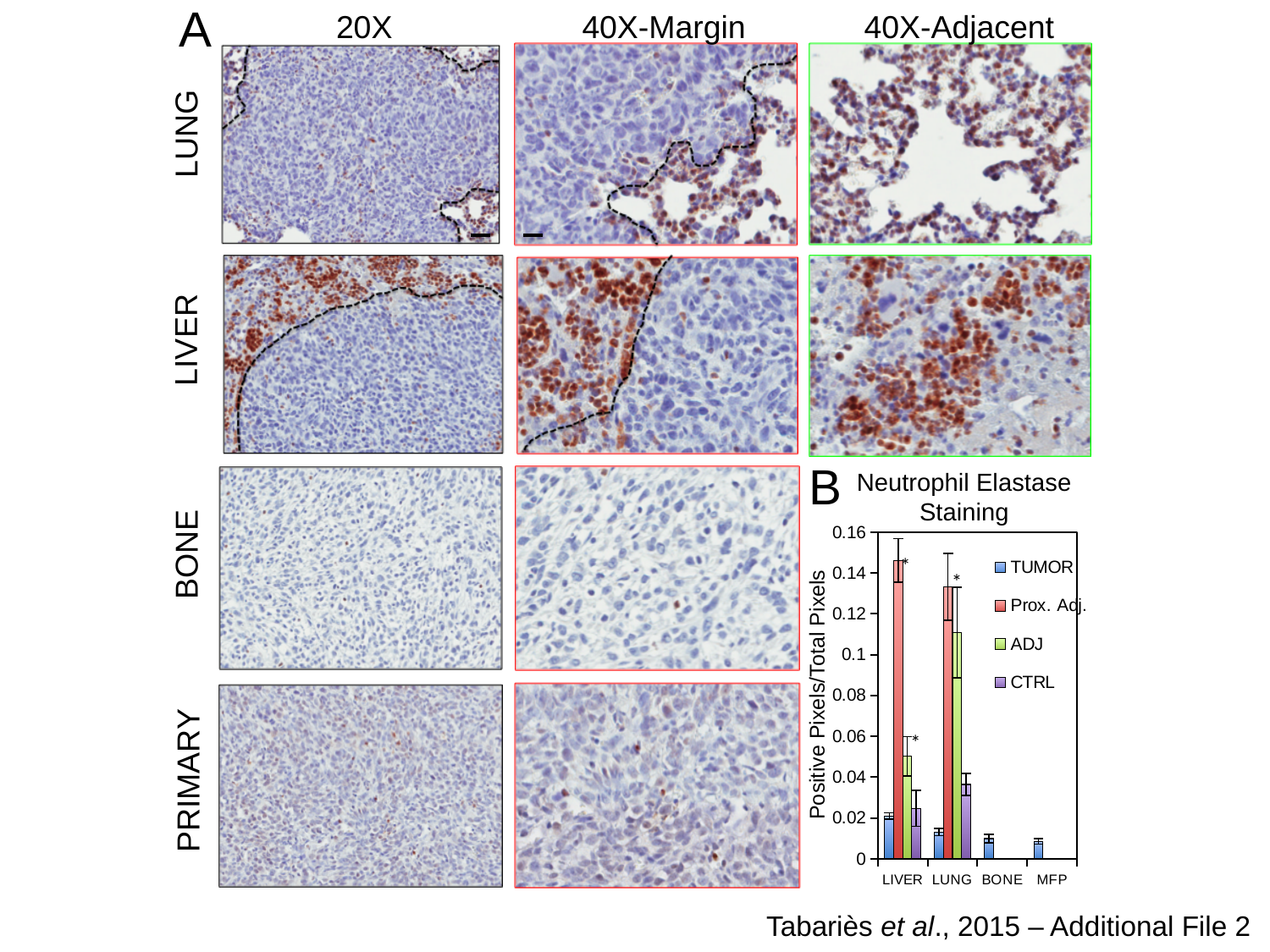
In the Neutrophil Elastase Staining chart, which series has the highest value for LUNG? Prox. Adj. In the Neutrophil Elastase Staining chart, which series has the highest value for LIVER? Prox. Adj. In the Neutrophil Elastase Staining chart, is the ADJ value for LIVER greater or less than 0.06? less How many series does the legend of the Neutrophil Elastase Staining chart list? 4 How many categories are shown on the x axis of the Neutrophil Elastase Staining chart? 4 In the Neutrophil Elastase Staining chart, is the TUMOR value for BONE greater or less than 0.02? less In the Neutrophil Elastase Staining chart, which is larger: the ADJ value for LIVER or the ADJ value for LUNG? LUNG What is the y-axis label of the Neutrophil Elastase Staining chart? Positive Pixels/Total Pixels What type of chart is shown in panel B? bar chart In the Neutrophil Elastase Staining chart, is the Prox. Adj. value for LIVER greater or less than 0.12? greater What is the title of the chart in panel B? Neutrophil Elastase Staining